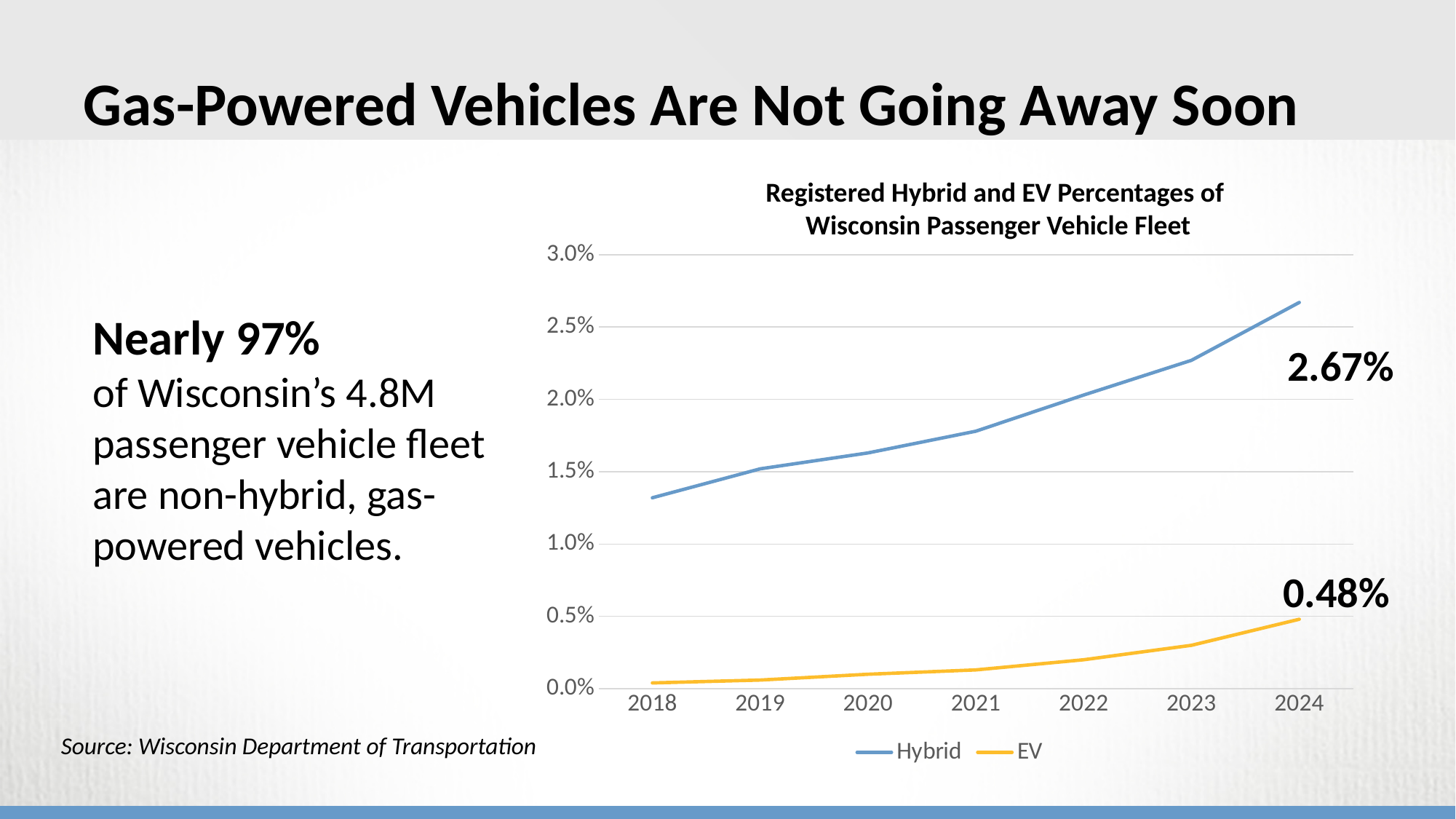
What is the difference between the Hybrid and EV percentages in 2024? 2.19% Is the Hybrid value for 2018 greater or less than 1.5%? less What is the EV percentage in 2024? 0.48% In which year is the Hybrid percentage highest? 2024 What is the Hybrid percentage in 2024? 2.67% In which year is the EV percentage lowest? 2018 What kind of chart is shown on the slide? line chart How many series does the legend list? 2 How many years are shown on the x axis? 7 Which series has the higher value in 2024, Hybrid or EV? Hybrid Is the EV value for 2021 greater or less than 0.5%? less